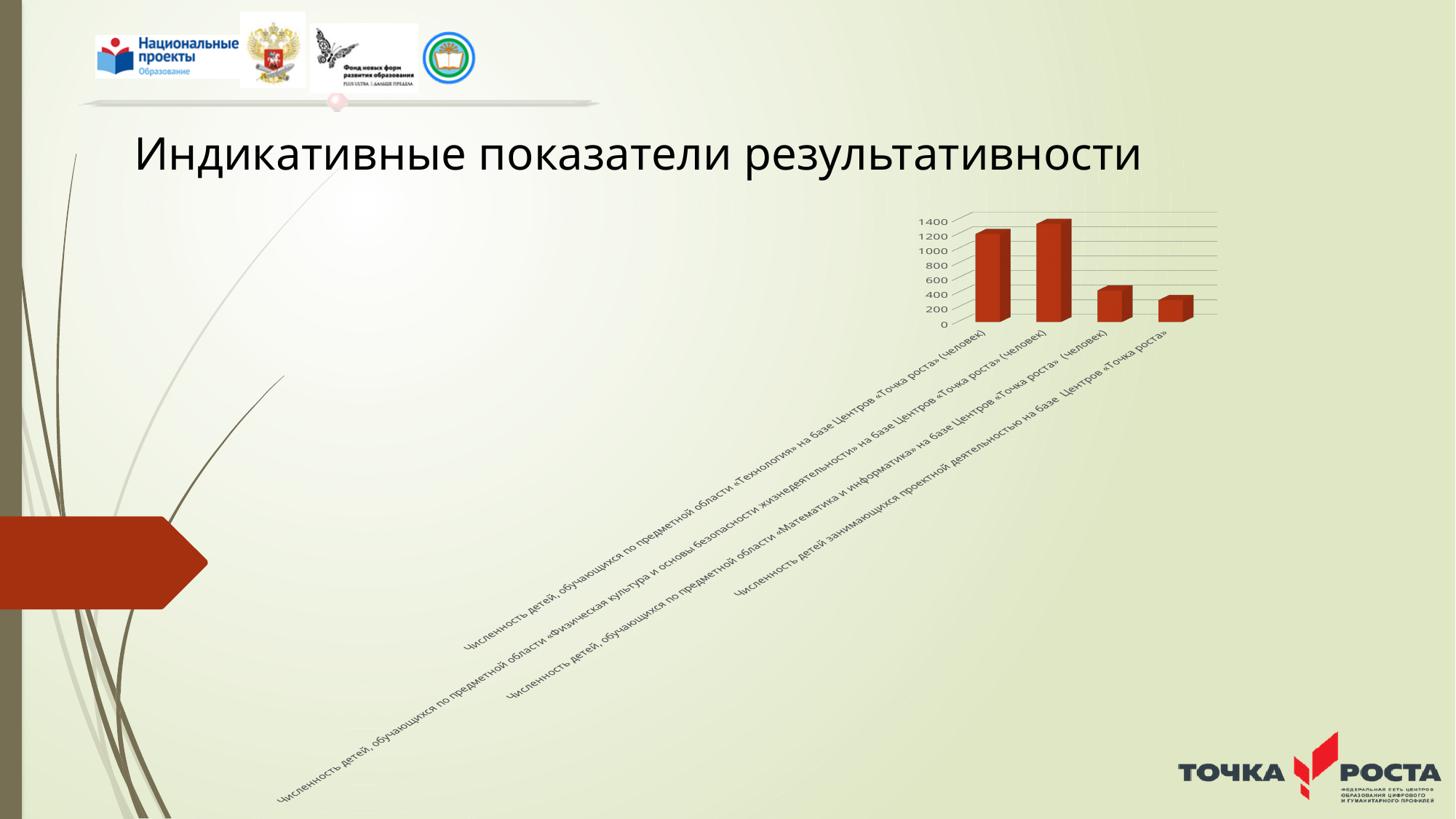
What is the title of the slide containing the chart? Индикативные показатели результативности Which category has the lowest bar in the chart? Численность детей занимающихся проектной деятельностью на базе Центров «Точка роста» Is the value for «Физическая культура и основы безопасности жизнедеятельности» greater or less than 1200? greater Which category has the highest bar in the chart? Численность детей, обучающихся по предметной области «Физическая культура и основы безопасности жизнедеятельности» на базе Центров «Точка роста» (человек) Which is larger: the value for «Технология» or the value for «Математика и информатика»? «Технология» What kind of chart is shown on the slide? bar chart Is the value for children engaged in project activity (проектной деятельностью) greater or less than 600? less Is the value for «Технология» greater or less than 1000? greater What is the highest tick value shown on the vertical axis of the chart? 1400 Which is larger: the value for «Физическая культура и основы безопасности жизнедеятельности» or the value for «Технология»? «Физическая культура и основы безопасности жизнедеятельности» How many categories (bars) does the chart show? 4